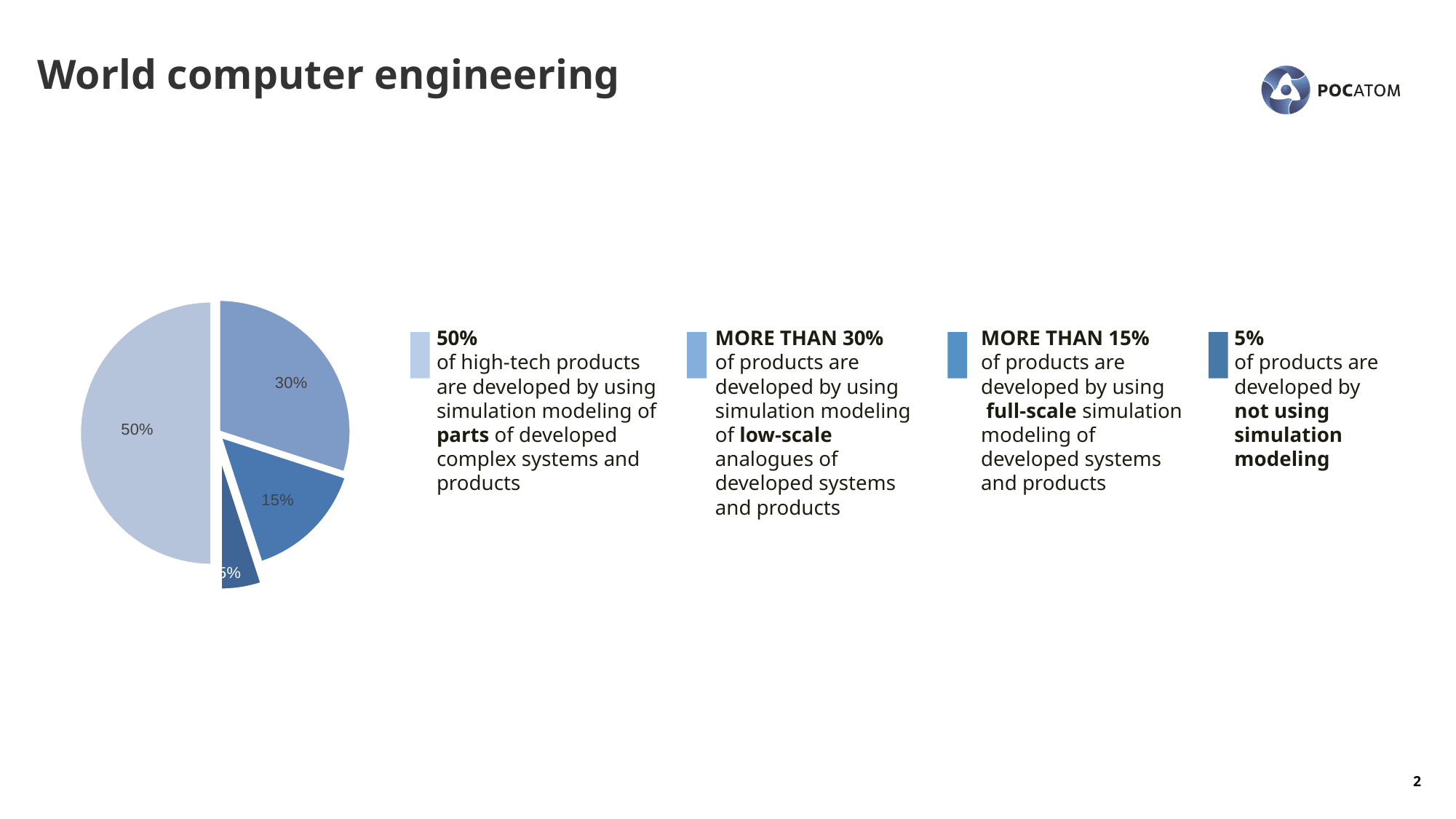
What is the difference between the 15% slice and the 5% slice? 10% What share of the pie is the smallest slice? 5% What percentage of high-tech products are developed by using simulation modeling of parts of developed complex systems and products? 50% What share of the pie is the largest slice? 50% What is the difference between the 50% slice and the 30% slice? 20% What is the title of the slide containing the pie chart? World computer engineering What percentage label is shown on the slice for products developed using full-scale simulation modeling? 15% What kind of chart is shown on the slide? pie chart How many slices does the pie chart have? 4 What percentage label is shown on the slice for products developed using simulation modeling of low-scale analogues? 30% Which is larger: the slice for full-scale simulation modeling or the slice for not using simulation modeling? full-scale simulation modeling What percentage of products are developed by not using simulation modeling? 5%